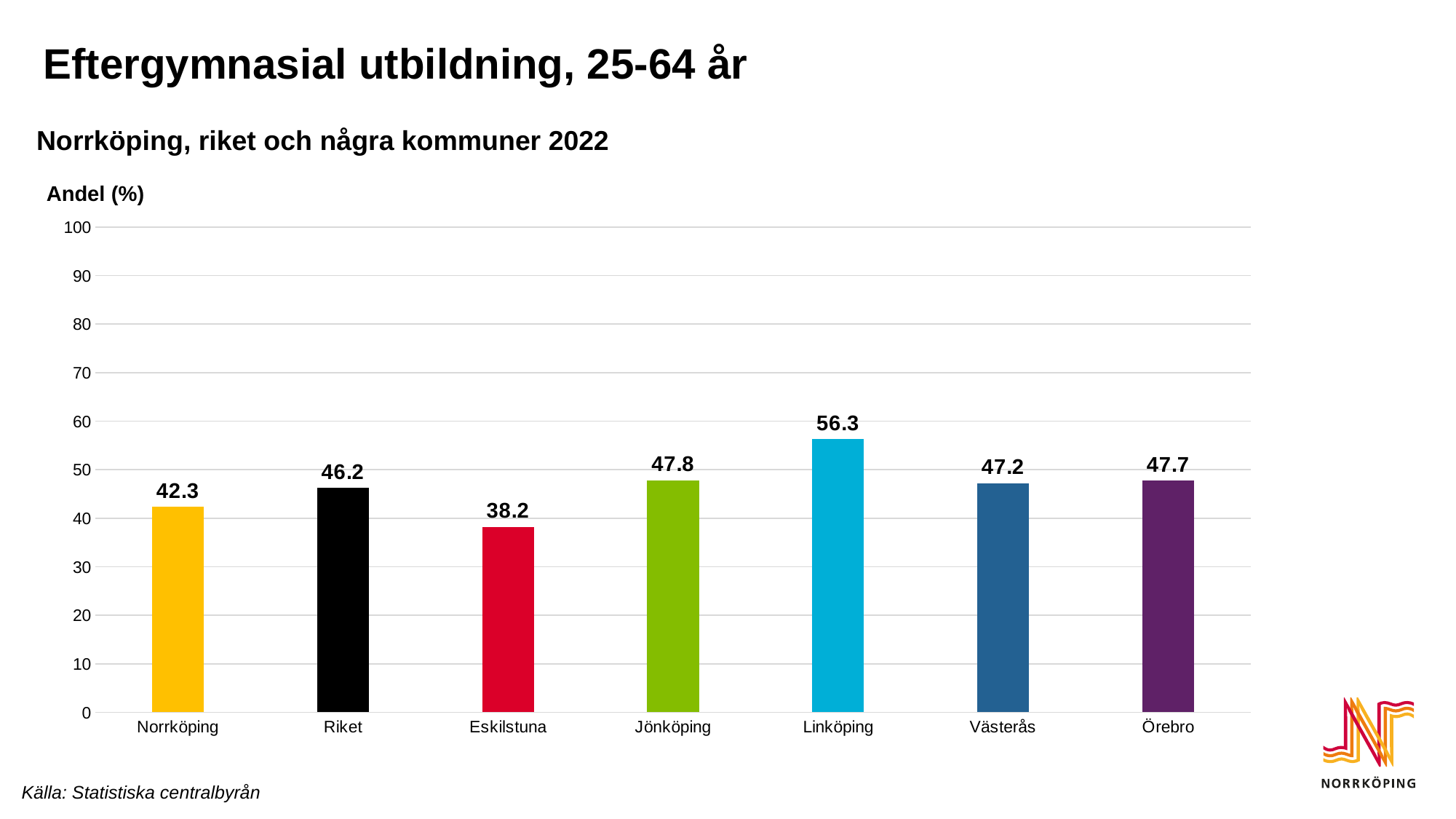
What is the value for Linköping? 56.3 What is the difference between the values for Linköping and Norrköping? 14 What is the label of the y axis? Andel (%) Which category has the highest value? Linköping What is the value for Norrköping? 42.3 Which is larger, the value for Jönköping or the value for Västerås? Jönköping How many categories are shown on the x axis? 7 What is the value for Riket? 46.2 Which category has the lowest value? Eskilstuna What is the difference between the values for Riket and Eskilstuna? 8 What kind of chart is shown on the slide? bar chart Is the value for Eskilstuna greater or less than 40? less